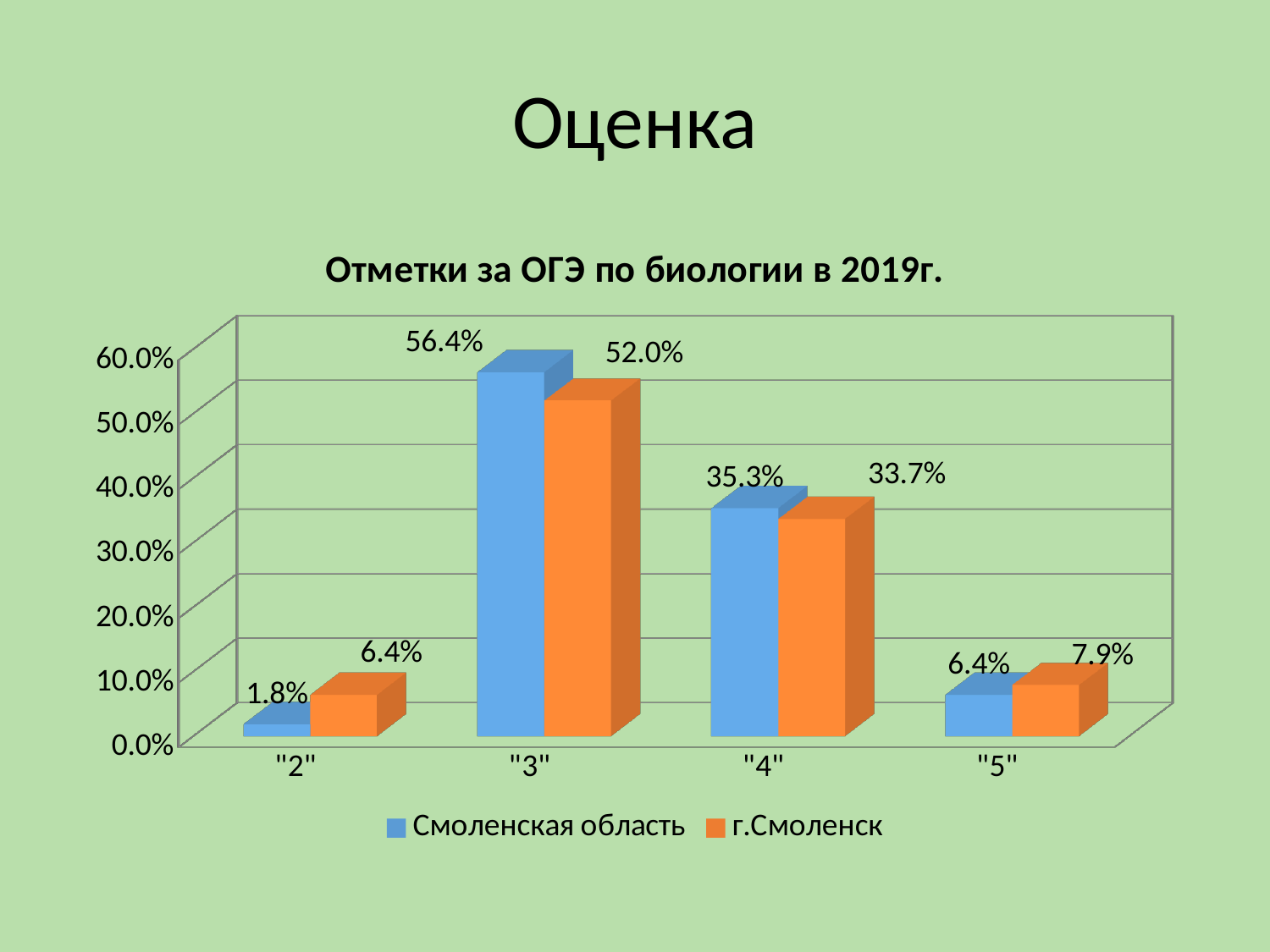
What is the value for "2" in the Смоленская область series? 1.8% What is the value for "3" in the Смоленская область series? 56.4% For grade "5", which series has the larger value, Смоленская область or г.Смоленск? г.Смоленск How many series does the legend list? 2 What is the title of the chart? Отметки за ОГЭ по биологии в 2019г. What is the value for "4" in the г.Смоленск series? 33.7% What is the value for "5" in the г.Смоленск series? 7.9% Which grade has the highest value in the г.Смоленск series? "3" What kind of chart is shown on the slide? Bar chart What is the difference between the Смоленская область and г.Смоленск values for "3"? 4.4% How many grade categories are shown on the x axis? 4 Which grade has the lowest value in the Смоленская область series? "2"